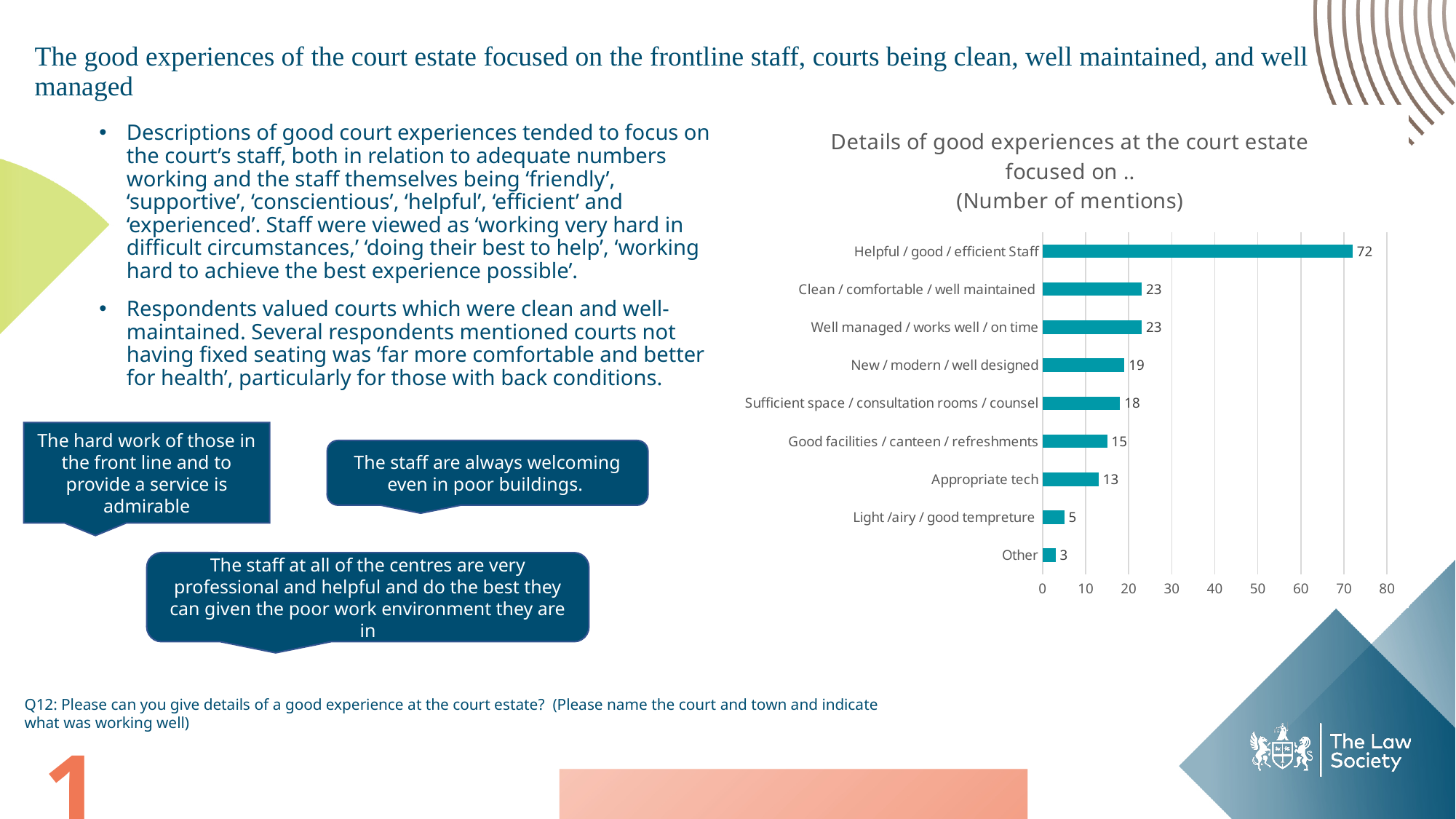
What is the number of mentions for 'New / modern / well designed'? 19 What is the title of the chart? Details of good experiences at the court estate focused on .. (Number of mentions) How many categories are shown in the chart? 9 What is the number of mentions for 'Helpful / good / efficient Staff'? 72 What is the difference in mentions between 'Sufficient space / consultation rooms / counsel' and 'Good facilities / canteen / refreshments'? 3 Which has more mentions, 'Light /airy / good tempreture' or 'Appropriate tech'? Appropriate tech Which category has the lowest number of mentions? Other What is the difference in mentions between 'Helpful / good / efficient Staff' and 'Clean / comfortable / well maintained'? 49 What is the number of mentions for 'Appropriate tech'? 13 What type of chart is shown on the slide? Bar chart Which category has the highest number of mentions? Helpful / good / efficient Staff Is the value for 'Helpful / good / efficient Staff' greater or less than 70? greater